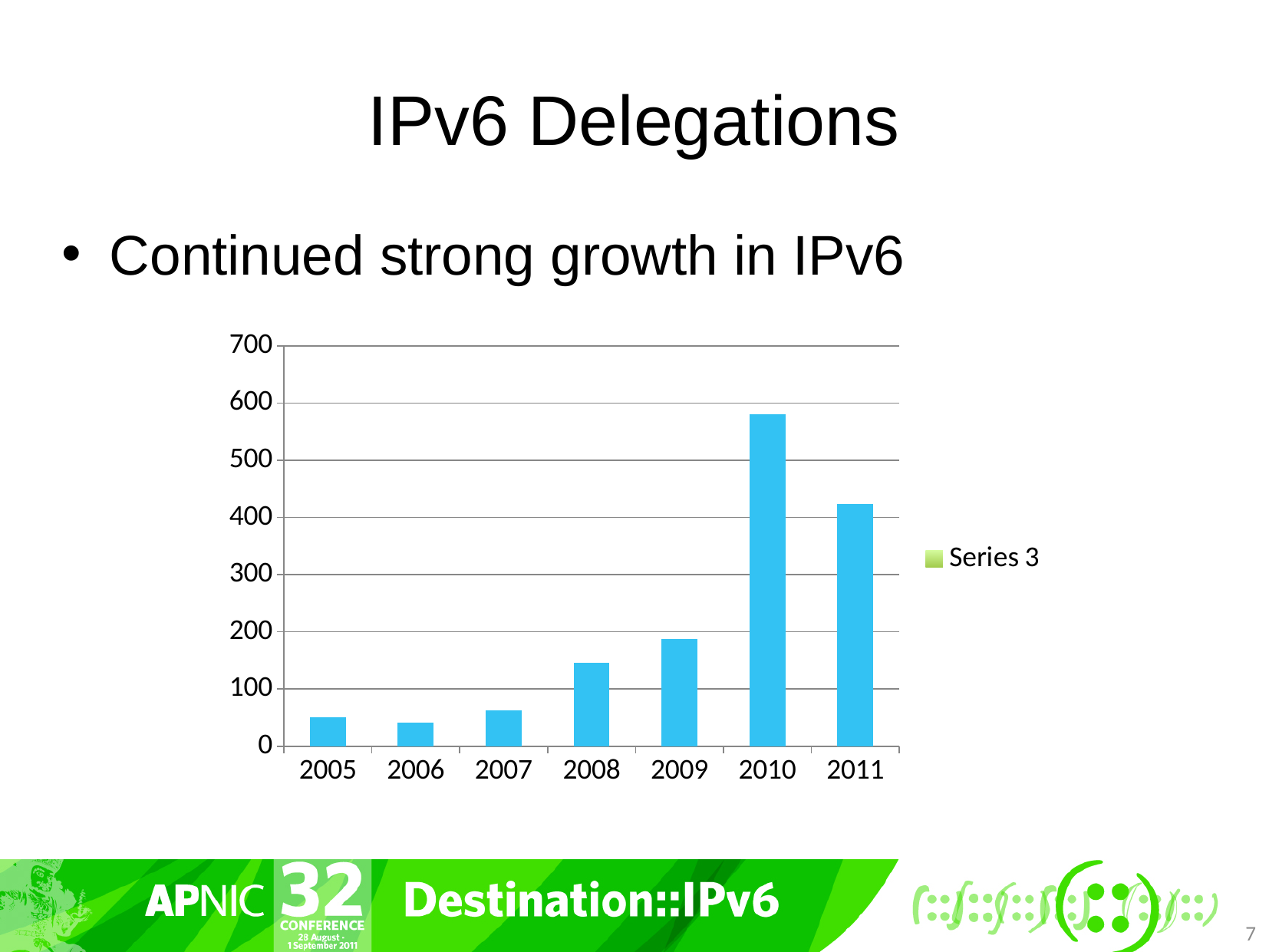
Which is larger, the value for 2010 or the value for 2011? 2010 Is the value for 2008 greater or less than 100? greater How many years are shown on the x axis of the chart? 7 How many series does the chart legend list? 1 Do the values rise or fall from 2007 to 2010? rise Which is larger, the value for 2008 or the value for 2009? 2009 Is the value for 2007 greater or less than 100? less Is the value for 2009 greater or less than 200? less What kind of chart is shown on the slide? bar chart What is the name of the series listed in the chart legend? Series 3 Which year has the highest value in the chart? 2010